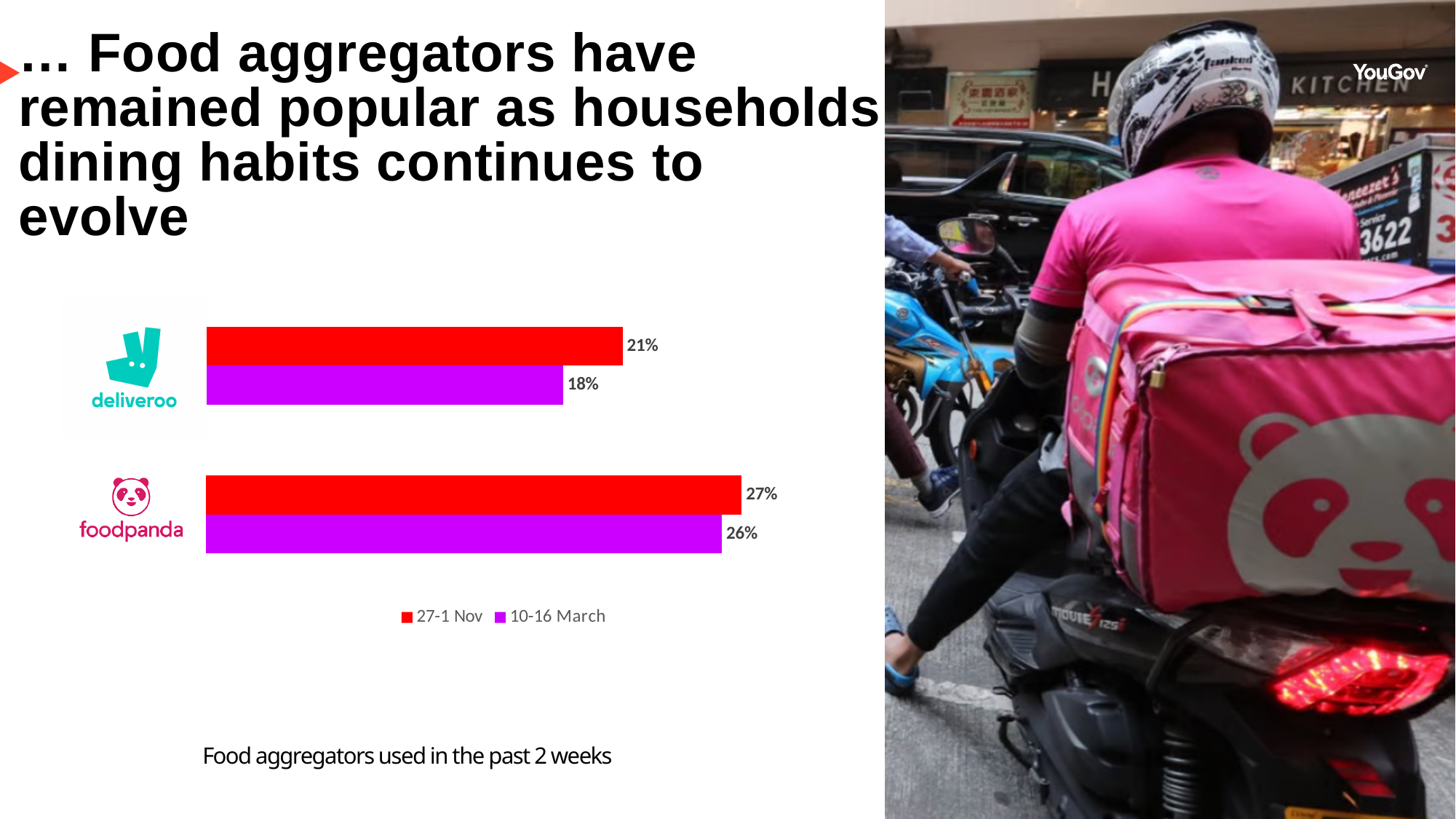
How many food aggregators are shown in the chart? 2 What type of chart is shown on the slide? Bar chart Which food aggregator had the lowest usage in the 10-16 March period? deliveroo Which food aggregator had the highest usage in the 27-1 Nov period? foodpanda What percentage of respondents used foodpanda in the 27-1 Nov period? 27% Which is larger: foodpanda's usage in 10-16 March or Deliveroo's usage in 27-1 Nov? foodpanda's usage in 10-16 March What percentage of respondents used Deliveroo in the 27-1 Nov period? 21% What is the difference between foodpanda's and Deliveroo's usage in the 27-1 Nov period? 6% What percentage of respondents used Deliveroo in the 10-16 March period? 18% What percentage of respondents used foodpanda in the 10-16 March period? 26% What is the difference between Deliveroo's usage in 27-1 Nov and 10-16 March? 3% How many series does the legend list? 2